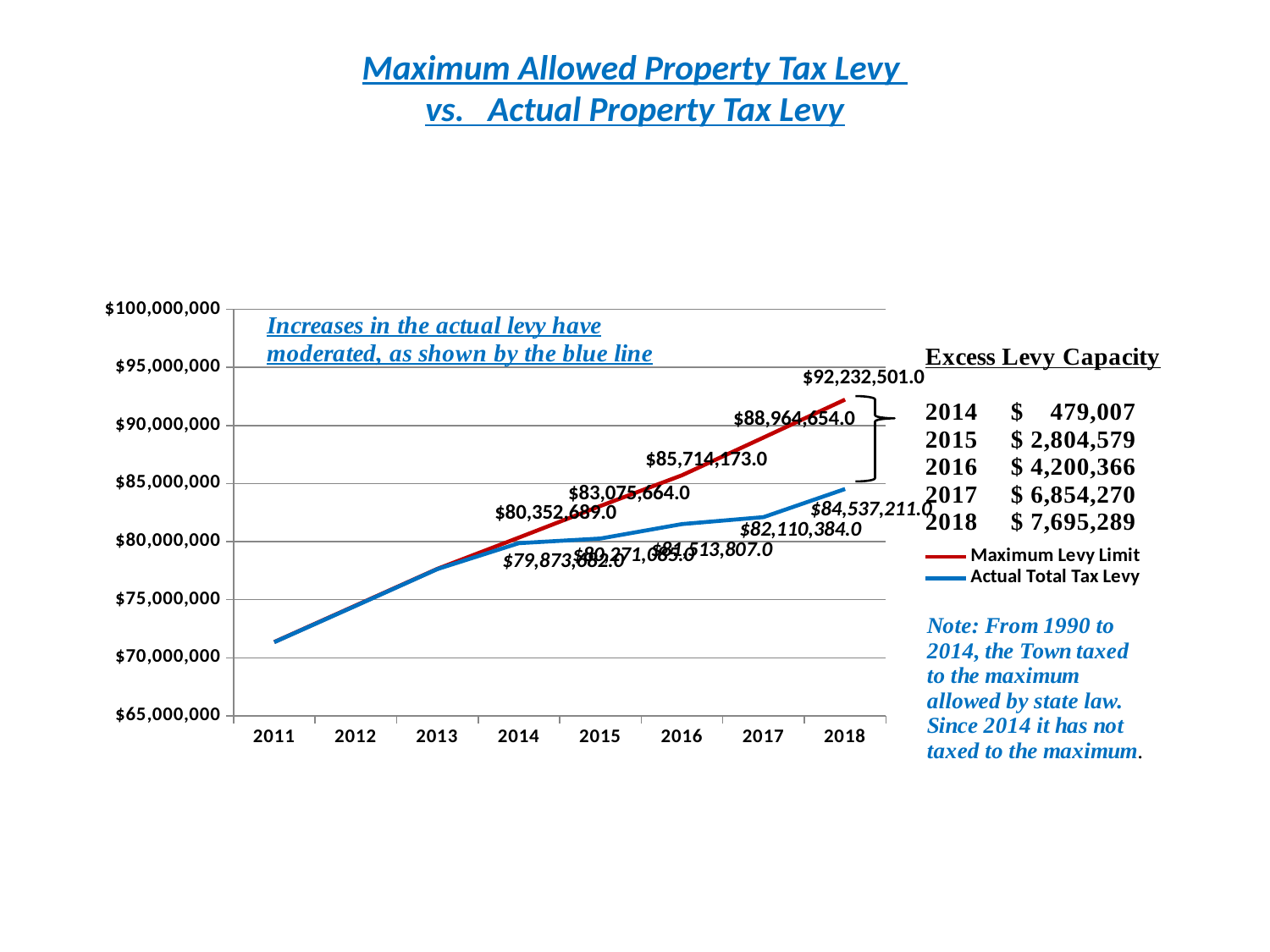
What kind of chart is shown on the slide? line chart What is the Actual Total Tax Levy value for 2018? $84,537,211.0 Is the Actual Total Tax Levy value for 2011 greater or less than $75,000,000? less What is the difference between the Maximum Levy Limit in 2018 and in 2017? $3,267,847 What is the Actual Total Tax Levy value for 2017? $82,110,384.0 How many years are shown on the x axis? 8 What is the Maximum Levy Limit value for 2016? $85,714,173.0 What is the Maximum Levy Limit value for 2018? $92,232,501.0 In 2018, which is larger: the Maximum Levy Limit or the Actual Total Tax Levy? Maximum Levy Limit Does the Maximum Levy Limit rise or fall from 2011 to 2018? rise How many series does the legend list? 2 What colour is the Actual Total Tax Levy line? blue